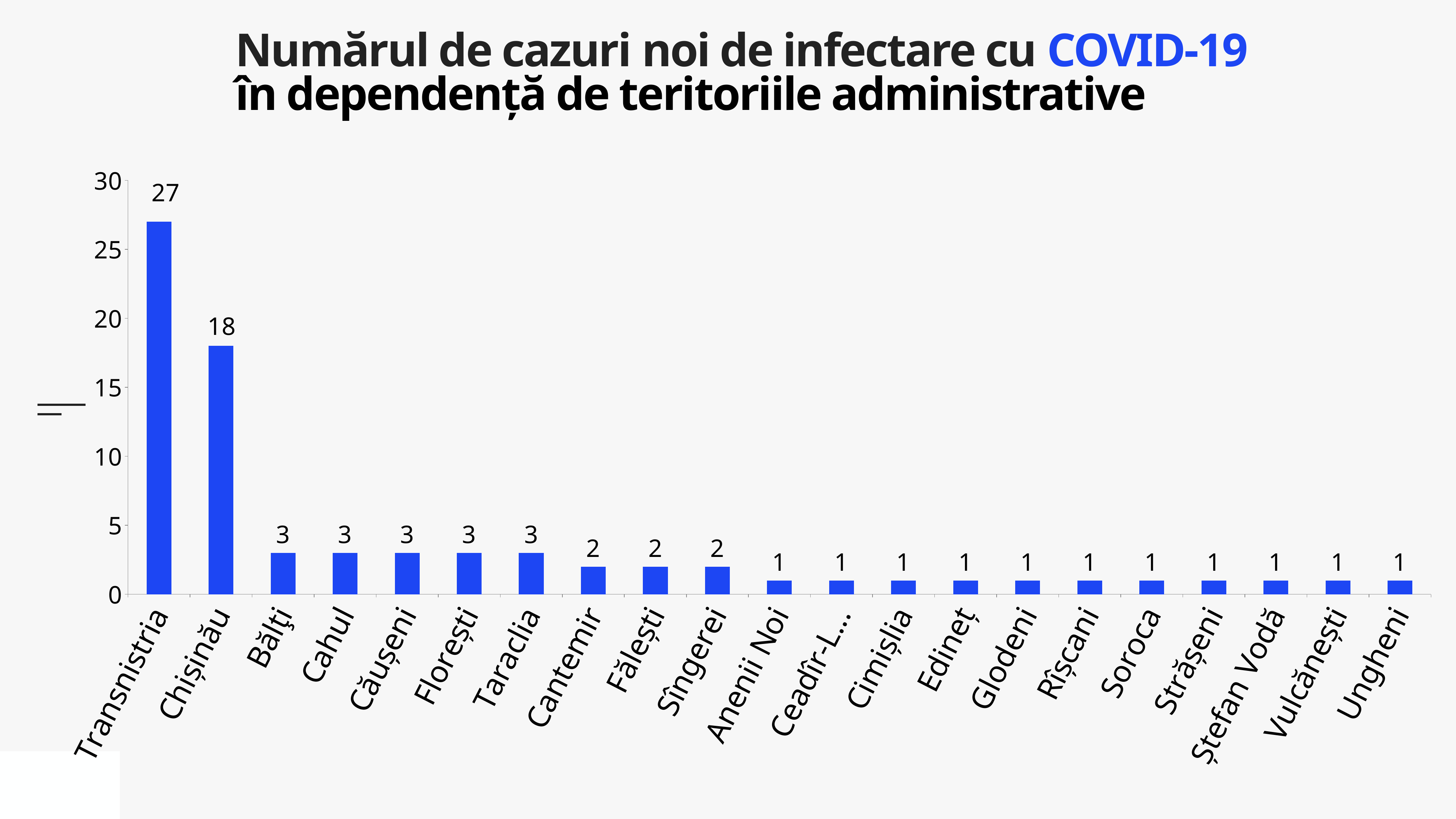
What kind of chart is shown on the slide? bar chart What is the value for Soroca? 1 What is the difference between the values for Transnistria and Chișinău? 9 Which is larger, the value for Chișinău or the value for Cahul? Chișinău What is the value for Transnistria? 27 What is the difference between the values for Bălți and Fălești? 1 Which territory has the highest number of new cases? Transnistria Do the values rise or fall from left to right along the x axis? fall How many territories are shown on the x axis? 21 What is the value for Cantemir? 2 What is the value for Chișinău? 18 Is the value for Transnistria greater or less than 25? greater